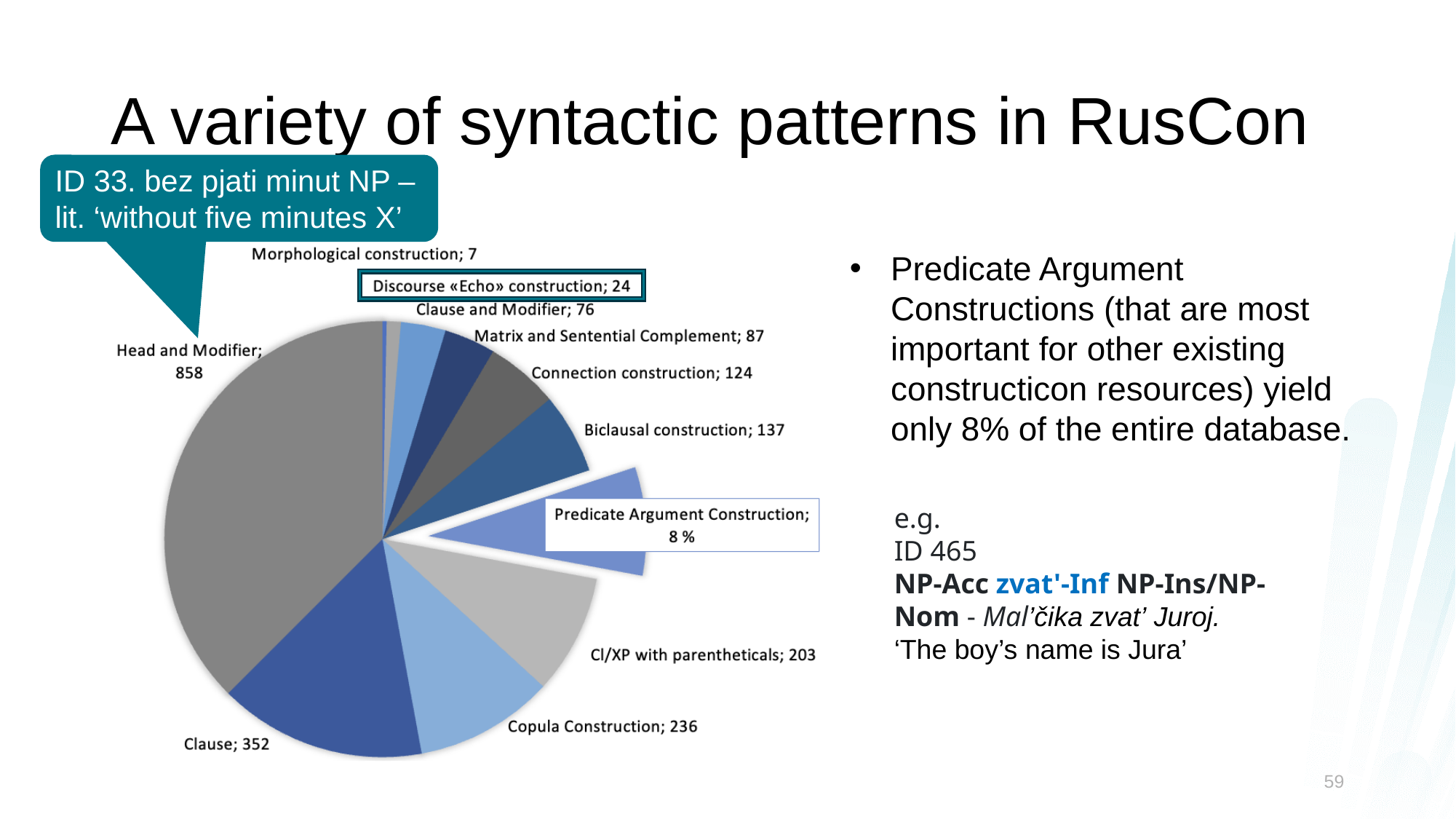
What is the value for Discourse «Echo» construction? 24 What is the value for Head and Modifier? 858 Which category has the smallest slice in the pie chart? Morphological construction Which is larger, Biclausal construction or Connection construction? Biclausal construction What is the difference between the values for Clause and Copula Construction? 116 What is the value for Clause? 352 Which category has the largest slice in the pie chart? Head and Modifier What share of the pie does Predicate Argument Construction represent? 8 % What kind of chart is shown on the slide? pie chart How many categories (slices) does the pie chart show? 11 Which slice is pulled out (exploded) from the pie chart? Predicate Argument Construction What is the value for Copula Construction? 236